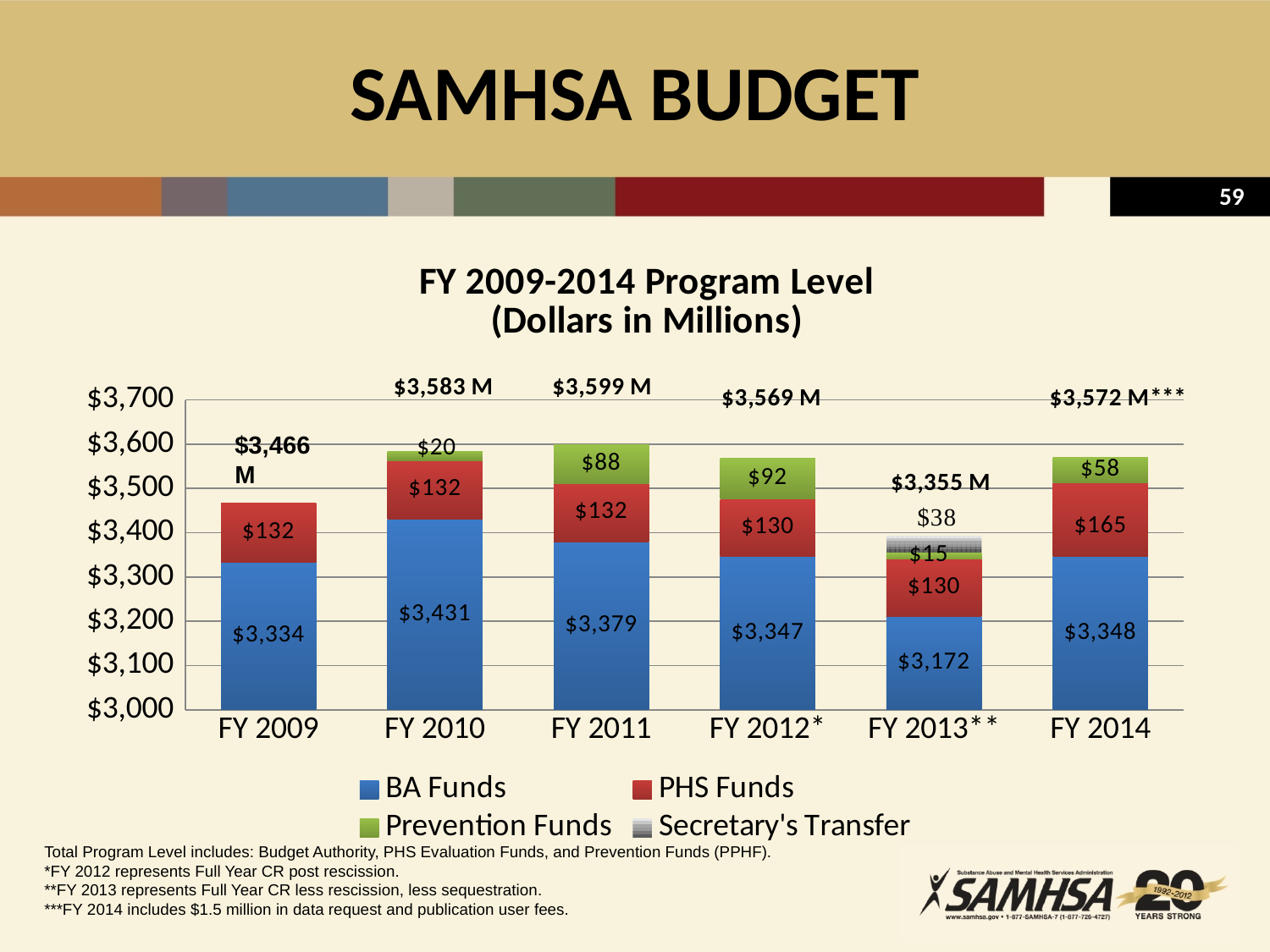
How many fiscal years are shown on the x axis? 6 What is the total program level labeled for FY 2011? $3,599 M What is the PHS Funds value for FY 2014? $165 Which is larger, the Prevention Funds value for FY 2011 or for FY 2014? FY 2011 What is the difference between the BA Funds values for FY 2010 and FY 2009? $97 How many series does the legend list? 4 What is the Secretary's Transfer value for FY 2013**? $38 Which fiscal year has the lowest BA Funds value? FY 2013** Which fiscal year has the highest total program level? FY 2011 What type of chart is shown on the slide? Stacked bar chart What is the BA Funds value for FY 2010? $3,431 What is the Prevention Funds value for FY 2012*? $92